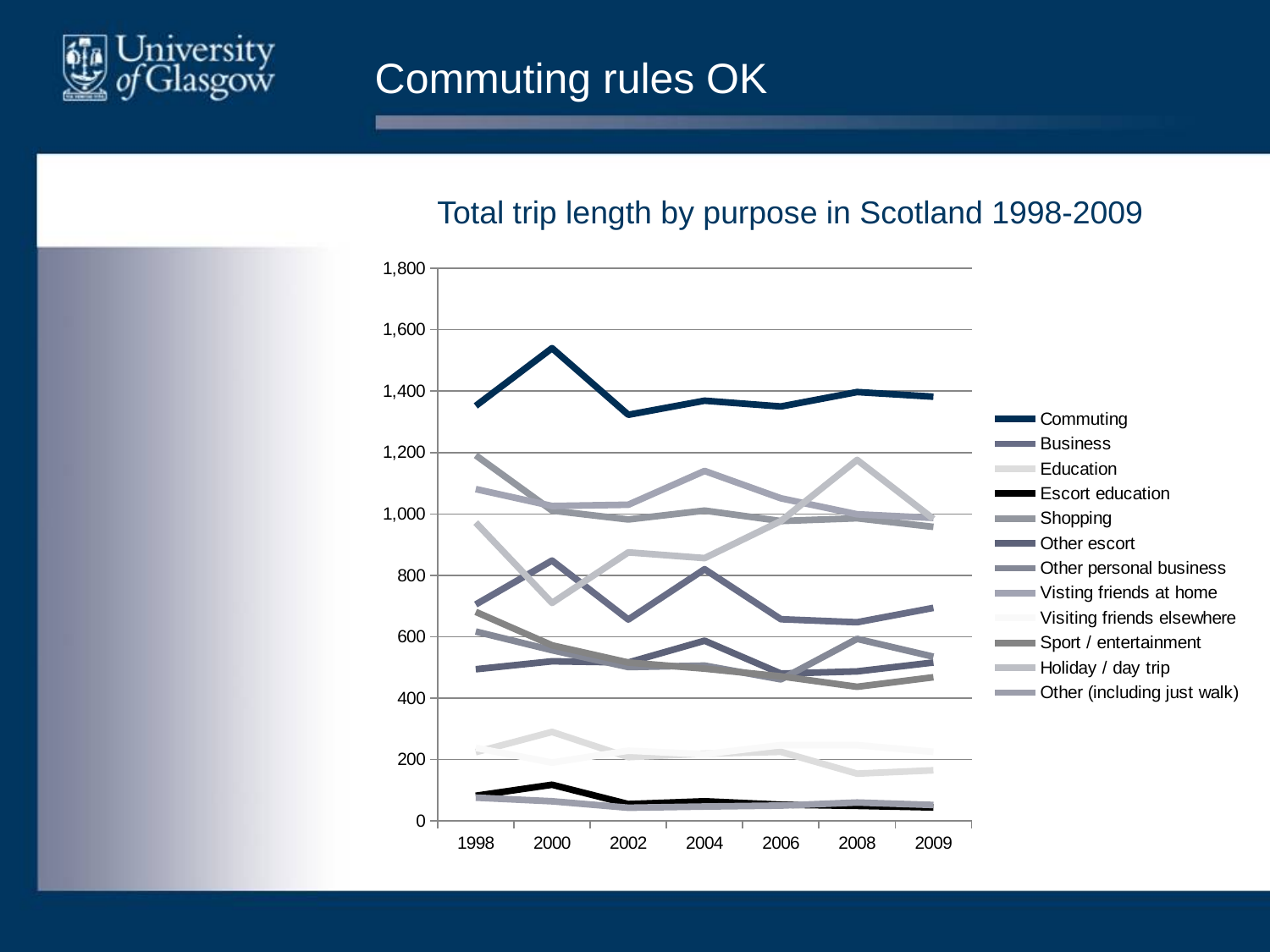
Is the value for Holiday / day trip in 2000 greater or less than 800? less What kind of chart is shown on the slide? Line chart Does the Commuting line rise or fall between 2000 and 2002? fall Is the value for Commuting in 2000 greater or less than 1,400? greater Is the value for Education in 2000 greater or less than 200? greater What is the title of the chart? Total trip length by purpose in Scotland 1998-2009 How many series does the legend list? 12 How many years are shown along the x axis? 7 Which is larger for Commuting: the value in 2000 or the value in 2002? 2000 Which series has the highest values across the whole chart? Commuting Which series is listed first in the legend? Commuting